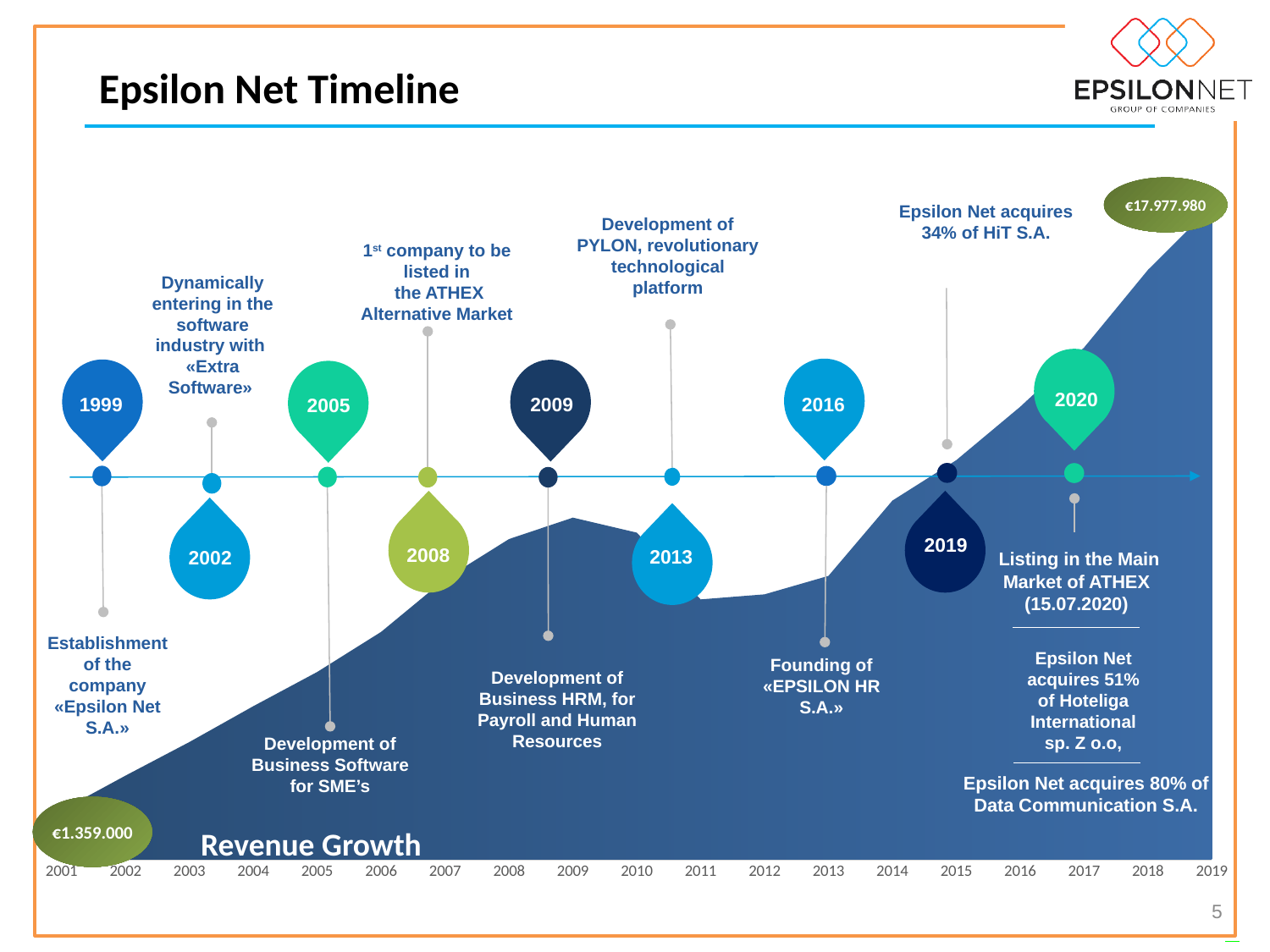
How many years are labelled on the x axis of the Revenue Growth chart? 19 What is the title of the chart at the bottom of the slide? Revenue Growth In the Revenue Growth chart, is revenue higher in 2009 or in 2012? 2009 What kind of chart is the Revenue Growth chart? Area chart What is the first year shown on the x axis of the Revenue Growth chart? 2001 In the Revenue Growth chart, which year has the lowest revenue? 2001 In the Revenue Growth chart, is revenue higher in 2019 or in 2001? 2019 In the Revenue Growth chart, which year has the highest revenue? 2019 Does revenue generally rise or fall from 2001 to 2019 in the Revenue Growth chart? Rise What revenue value is labelled at the start of the Revenue Growth chart (2001)? €1.359.000 What is the difference between the labelled revenue for 2019 and the labelled revenue for 2001 in the Revenue Growth chart? €16.618.980 What revenue value is labelled at the end of the Revenue Growth chart (2019)? €17.977.980